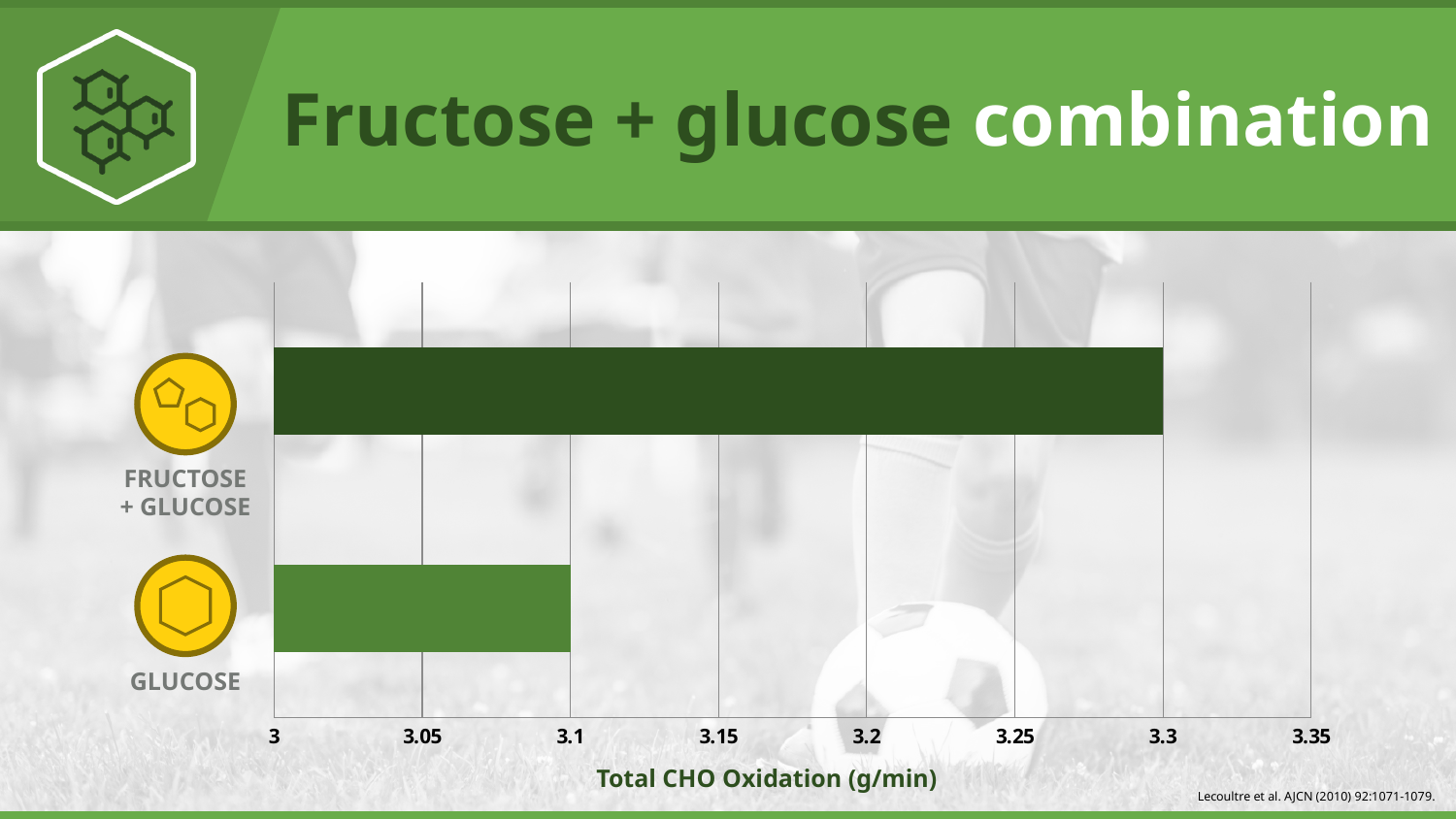
What is the difference in Total CHO Oxidation between Fructose + Glucose and Glucose? 0.2 What is the Total CHO Oxidation value for Glucose? 3.1 What is the label of the x axis? Total CHO Oxidation (g/min) Is the value for Fructose + Glucose greater or less than 3.2? greater Which category has the lowest Total CHO Oxidation? Glucose Which category has the highest Total CHO Oxidation? Fructose + Glucose What is the Total CHO Oxidation value for Fructose + Glucose? 3.3 How many categories are plotted in the chart? 2 What kind of chart is shown on the slide? bar chart Is the value for Glucose greater or less than 3.15? less Which has a larger Total CHO Oxidation value, Glucose or Fructose + Glucose? Fructose + Glucose What is the highest tick value shown on the x axis? 3.35